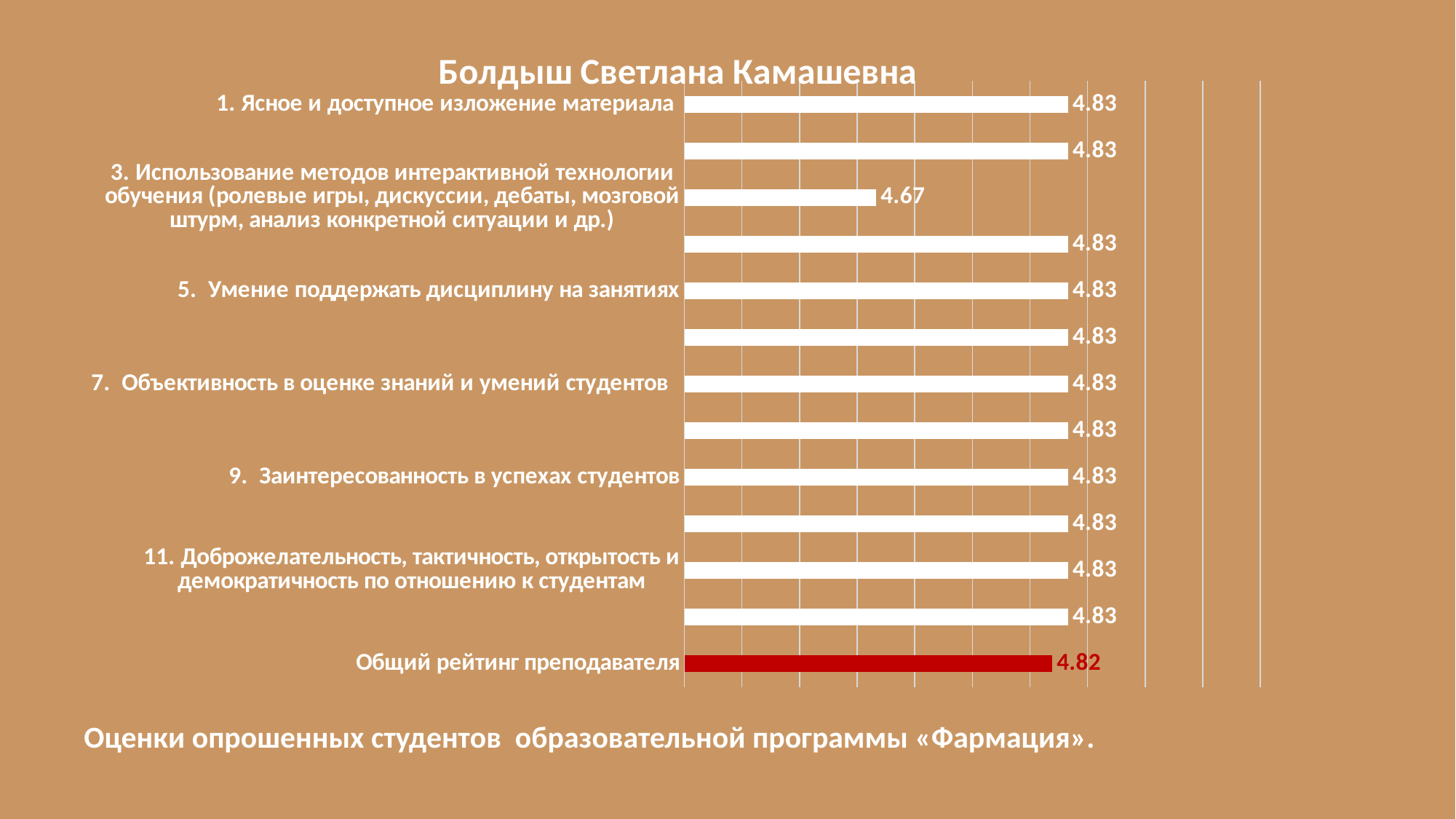
How many bars are plotted in the chart? 13 What is the value for "11. Доброжелательность, тактичность, открытость и демократичность по отношению к студентам"? 4.83 Which category has the lowest value? 3. Использование методов интерактивной технологии обучения What is the value for "1. Ясное и доступное изложение материала"? 4.83 What is the difference between the value for "9. Заинтересованность в успехах студентов" and "Общий рейтинг преподавателя"? 0.01 What is the value for "3. Использование методов интерактивной технологии обучения"? 4.67 Which is larger: the value for "7. Объективность в оценке знаний и умений студентов" or the value for "3. Использование методов интерактивной технологии обучения"? 7. Объективность в оценке знаний и умений студентов What kind of chart is shown on the slide? Bar chart What is the value for "5. Умение поддержать дисциплину на занятиях"? 4.83 What is the title of the chart? Болдыш Светлана Камашевна What is the difference between the value for item 1 (Ясное и доступное изложение материала) and item 3 (Использование методов интерактивной технологии обучения)? 0.16 What is the value for "Общий рейтинг преподавателя"? 4.82